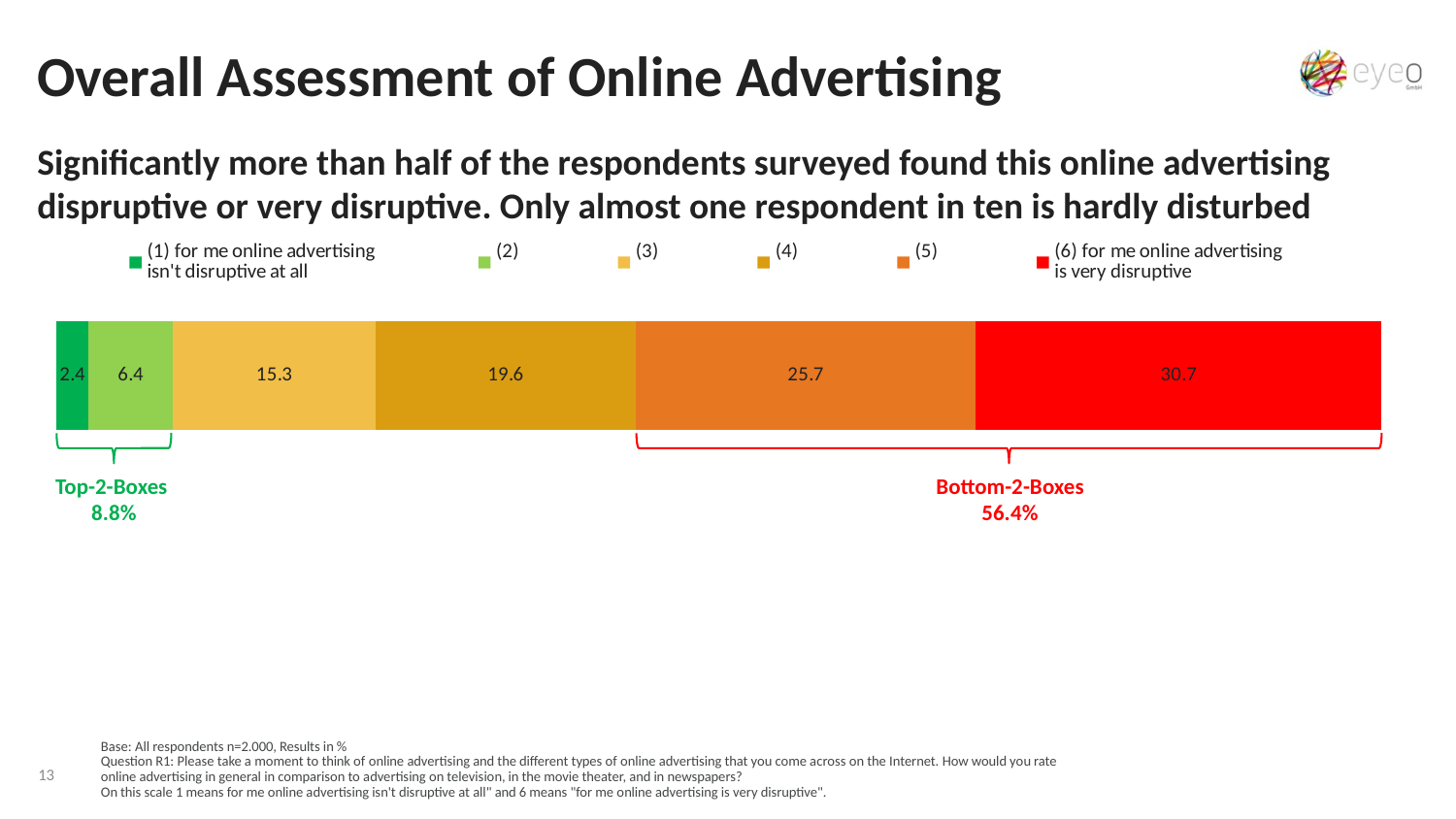
What is the difference between the values for segment (5) and segment (3)? 10.4 Which is larger, the value for segment (2) or segment (3)? (3) What kind of chart is shown on the slide? Stacked bar chart How many segments does the stacked bar contain? 6 What is the value for the segment '(6) for me online advertising is very disruptive'? 30.7 What is the value for the segment '(1) for me online advertising isn't disruptive at all'? 2.4 Which segment has the lowest value? (1) for me online advertising isn't disruptive at all What is the value for segment (4)? 19.6 What is the Top-2-Boxes percentage shown below the chart? 8.8% Which segment has the highest value? (6) for me online advertising is very disruptive What is the Bottom-2-Boxes percentage shown below the chart? 56.4% How many series does the legend list? 6